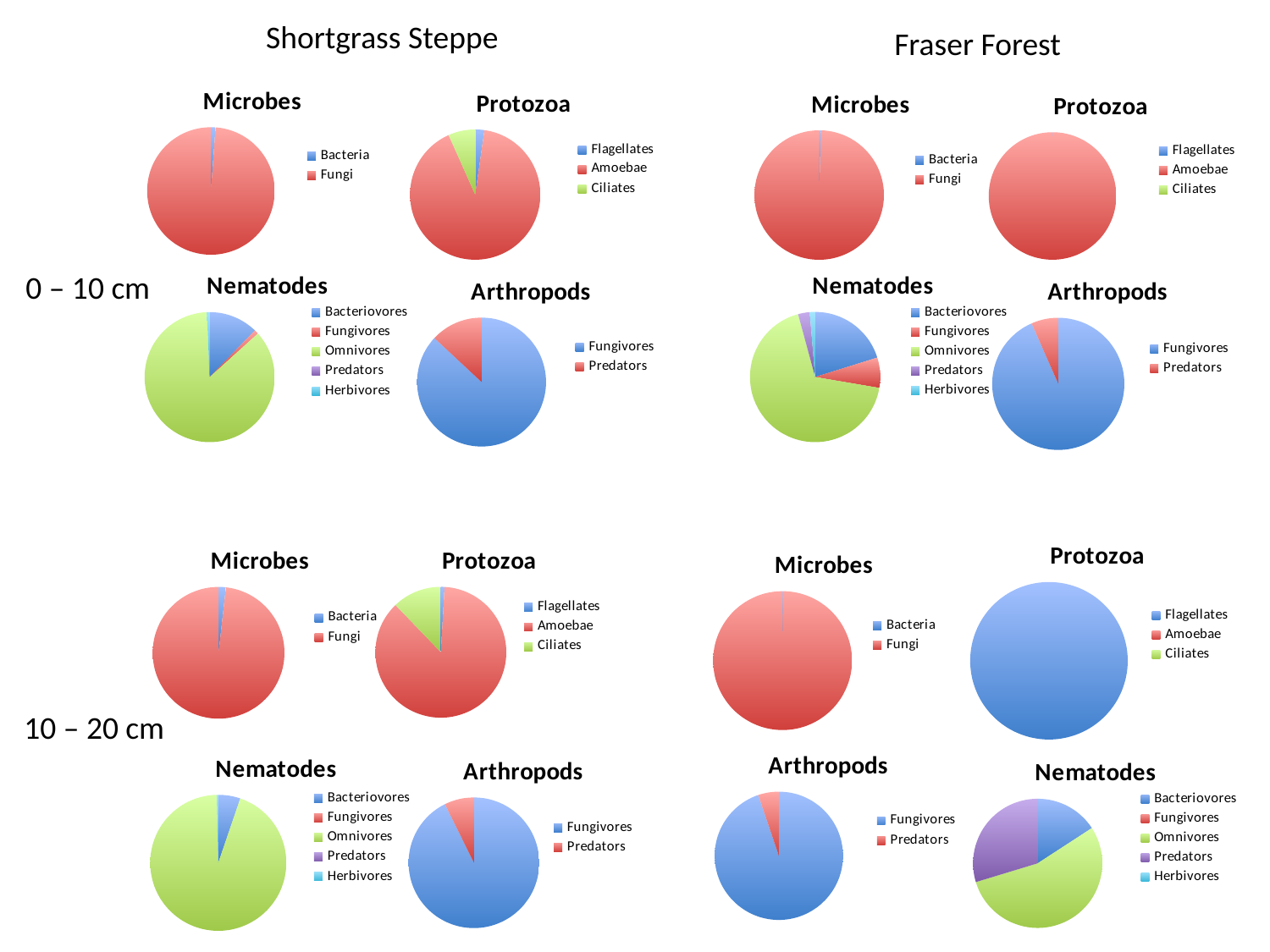
In the Shortgrass Steppe 0 – 10 cm Nematodes chart, which category has the largest slice? Omnivores How many entries does the legend of the Shortgrass Steppe 10 – 20 cm Protozoa chart list? 3 In the Fraser Forest 0 – 10 cm Nematodes chart, which category has the largest slice? Omnivores What kind of chart is the Shortgrass Steppe 0 – 10 cm Microbes chart? pie chart How many pie charts are shown on the slide in total? 16 In the Shortgrass Steppe 0 – 10 cm Arthropods chart, which category has the largest slice? Fungivores In the Shortgrass Steppe 10 – 20 cm Protozoa chart, which slice is larger, Ciliates or Flagellates? Ciliates In the Fraser Forest 10 – 20 cm Nematodes chart, which slice is larger, Omnivores or Predators? Omnivores In the Shortgrass Steppe 0 – 10 cm Microbes chart, which category has the smallest slice? Bacteria How many entries does the legend of the Shortgrass Steppe 0 – 10 cm Nematodes chart list? 5